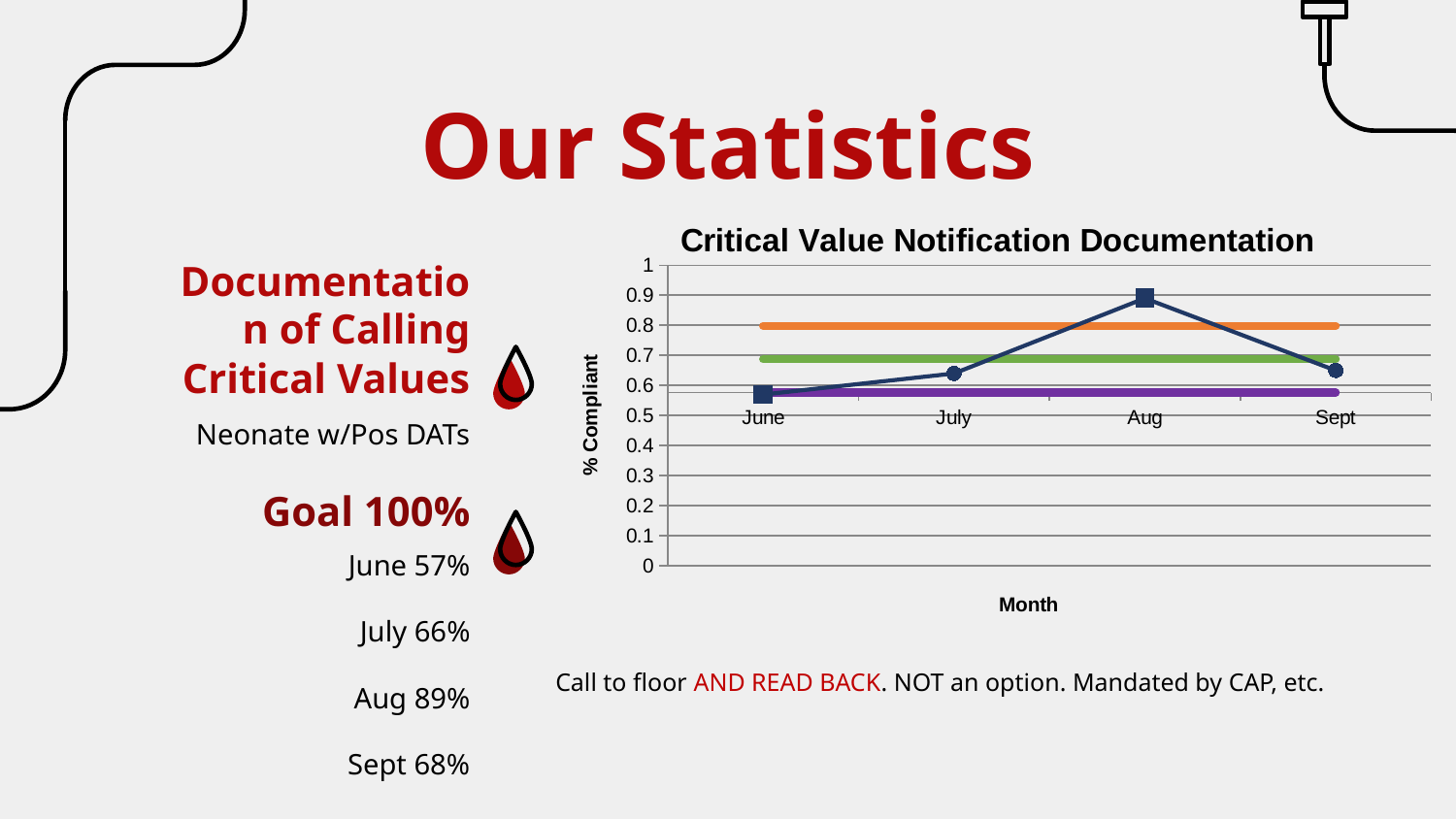
Is the value for June greater or less than 0.6? less Does the plotted line rise or fall from June to Aug? rise Which month has the lowest value on the plotted line? June Which month has the highest value on the plotted line? Aug How many months are plotted along the x axis of the chart? 4 Which is larger, the value for June or the value for Sept? Sept What is the title of the chart? Critical Value Notification Documentation What kind of chart is shown on the slide? line chart Is the value for July greater or less than 0.6? greater Is the value for Aug greater or less than 0.8? greater Which is larger, the value for Aug or the value for July? Aug What is the label on the y axis of the chart? % Compliant